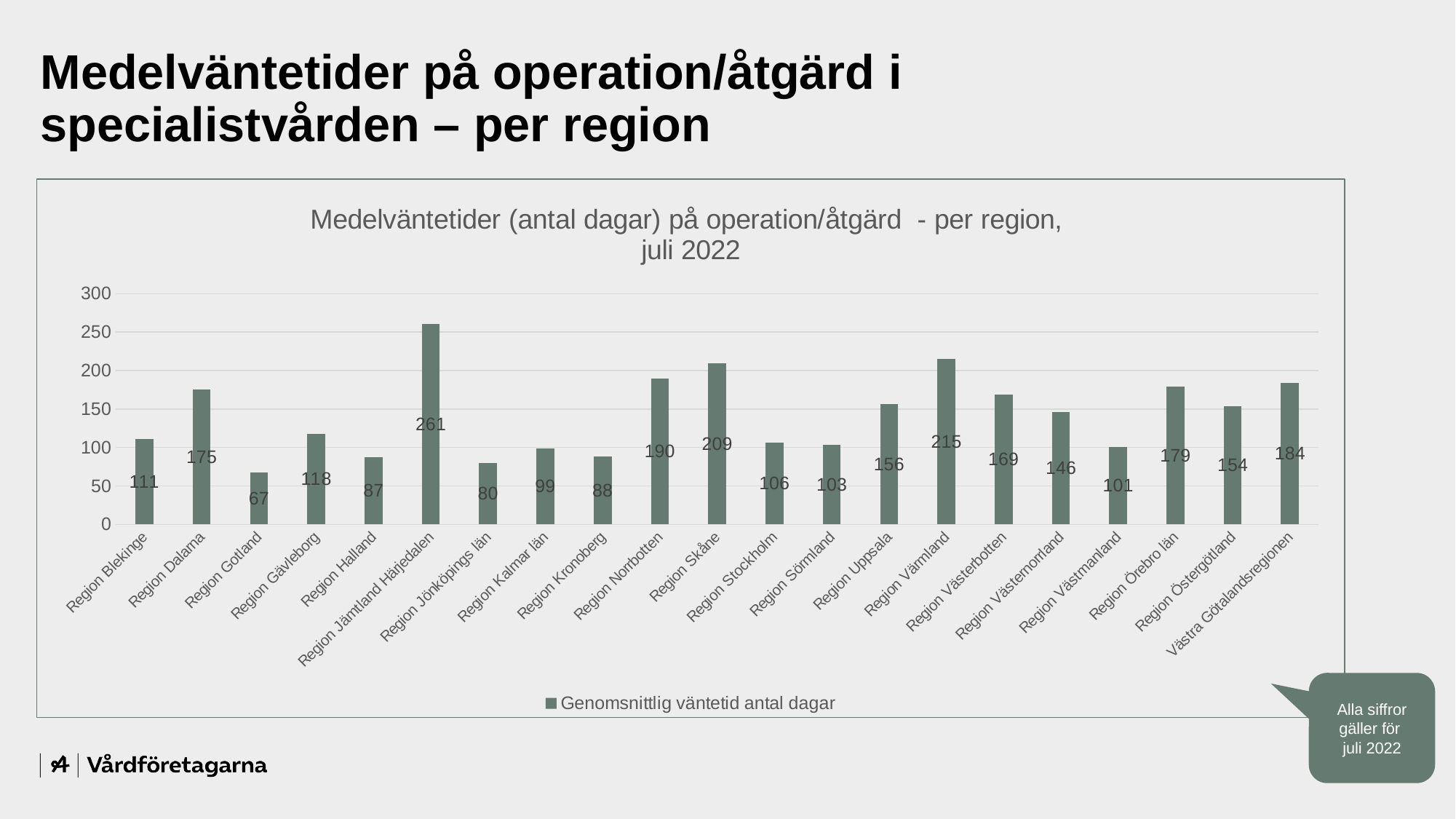
What is the value for Region Jämtland Härjedalen? 261 What kind of chart is shown on the slide? Bar chart What is the difference between the values for Region Värmland and Region Norrbotten? 25 Is the value for Region Uppsala greater or less than 150? greater What is the value for Region Skåne? 209 Which region has the lowest average waiting time? Region Gotland What is the value for Region Gotland? 67 What is the value for Västra Götalandsregionen? 184 How many regions are shown in the chart? 21 Which is larger, the value for Region Dalarna or the value for Region Örebro län? Region Örebro län Which region has the highest average waiting time? Region Jämtland Härjedalen How many series does the legend list? 1